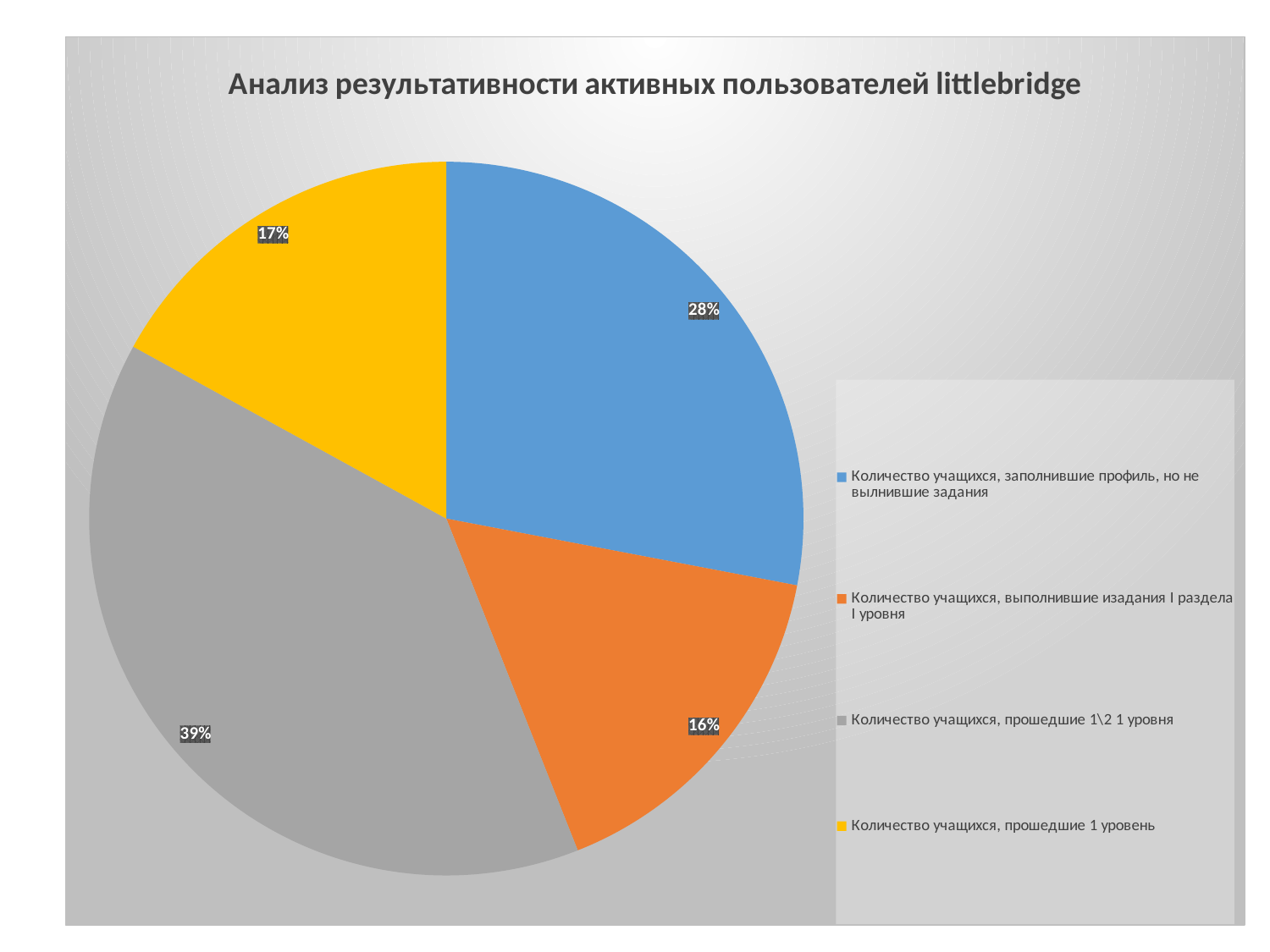
What share of the pie is labelled for "Количество учащихся, прошедшие 1\2 1 уровня"? 39% What share of the pie is labelled for "Количество учащихся, заполнившие профиль, но не вылнившие задания"? 28% Which category has the smallest slice of the pie? Количество учащихся, выполнившие изадания I раздела I уровня What is the title of the chart? Анализ результативности активных пользователей littlebridge What share of the pie is labelled for "Количество учащихся, прошедшие 1 уровень"? 17% What colour is the slice for "Количество учащихся, прошедшие 1 уровень"? yellow What type of chart is shown on the slide? pie chart What is the difference in percentage points between the slice for "Количество учащихся, прошедшие 1\2 1 уровня" and the slice for "Количество учащихся, заполнившие профиль, но не вылнившие задания"? 11% Which category has the largest slice of the pie? Количество учащихся, прошедшие 1\2 1 уровня How many slices does the pie chart have? 4 Which slice is larger: "Количество учащихся, заполнившие профиль, но не вылнившие задания" or "Количество учащихся, прошедшие 1 уровень"? Количество учащихся, заполнившие профиль, но не вылнившие задания